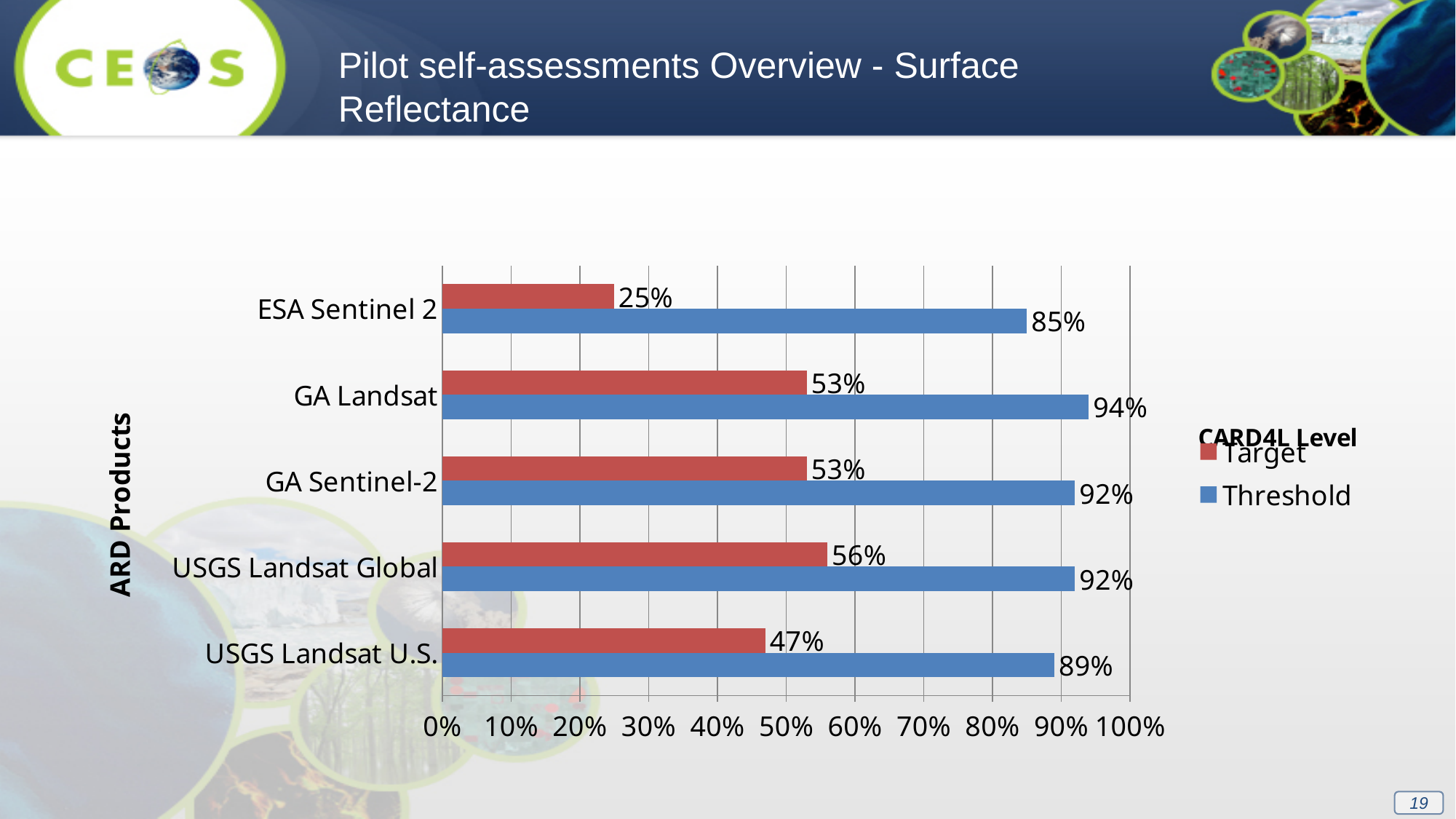
What is the title of the legend on the chart? CARD4L Level What is the difference between the Threshold and Target values for GA Sentinel-2? 39% How many ARD products are shown on the chart? 5 What kind of chart is shown on the slide? Bar chart How many series does the legend list? 2 Which ARD product has the highest Threshold value? GA Landsat What is the Threshold value for GA Landsat? 94% What is the Target value for ESA Sentinel 2? 25% What is the Target value for USGS Landsat Global? 56% Which ARD product has the lowest Target value? ESA Sentinel 2 Which is larger, the Target value for USGS Landsat Global or the Target value for USGS Landsat U.S.? USGS Landsat Global What is the Threshold value for USGS Landsat U.S.? 89%